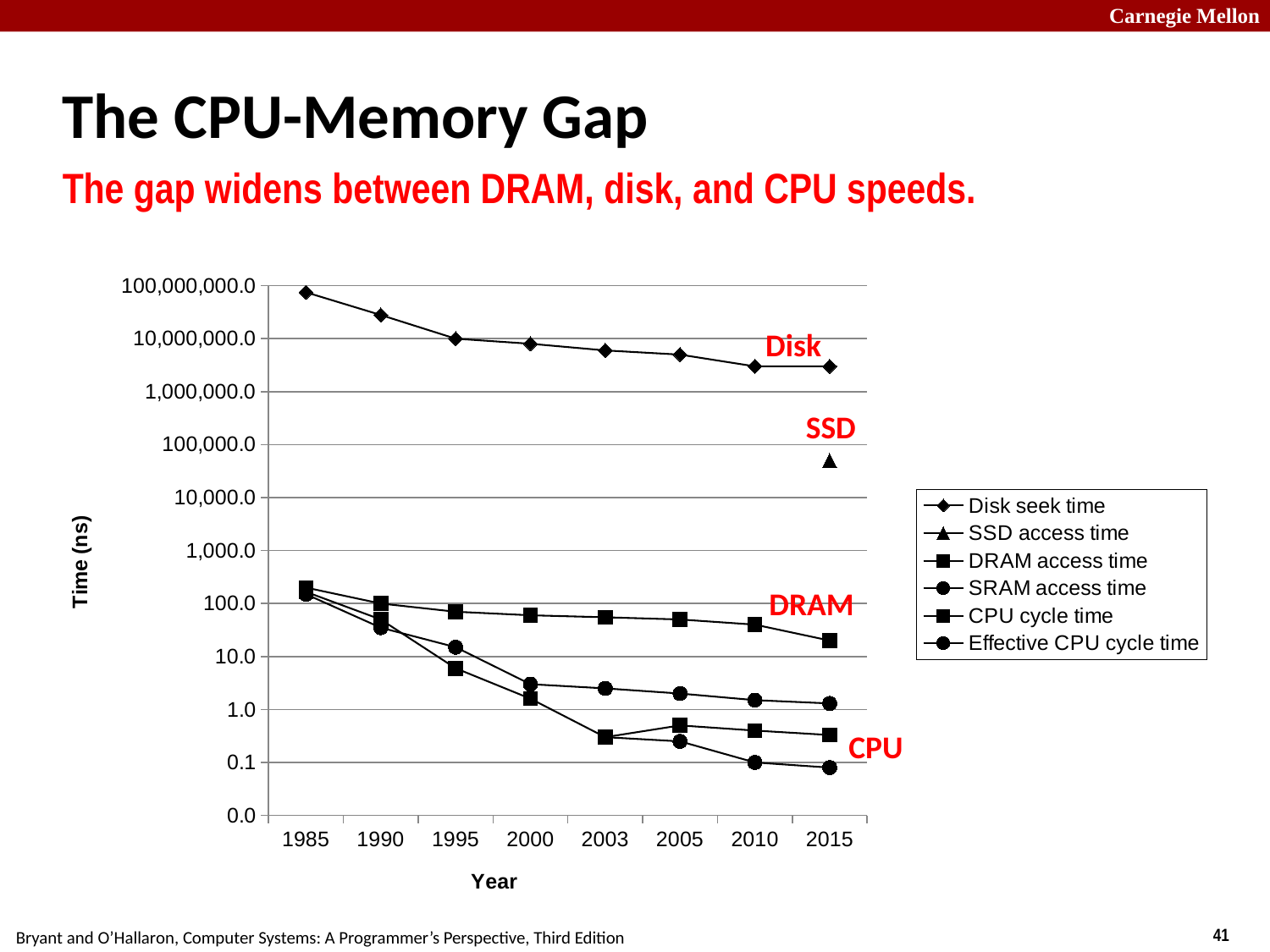
What kind of chart is shown on the slide? line chart Is the Disk seek time in 1985 greater or less than 10,000,000.0? greater How many series does the legend list? 6 Which series has the highest value in 2015? Disk seek time Is the CPU cycle time in 2015 greater or less than 1.0? less Does the Disk seek time rise or fall from 1985 to 2015? fall Is the DRAM access time in 2015 greater or less than 10.0? greater How many years are plotted along the x axis? 8 What is the label on the y axis? Time (ns) Which series has the lowest value in 2015? Effective CPU cycle time Which is larger in 2015, the DRAM access time or the SRAM access time? DRAM access time